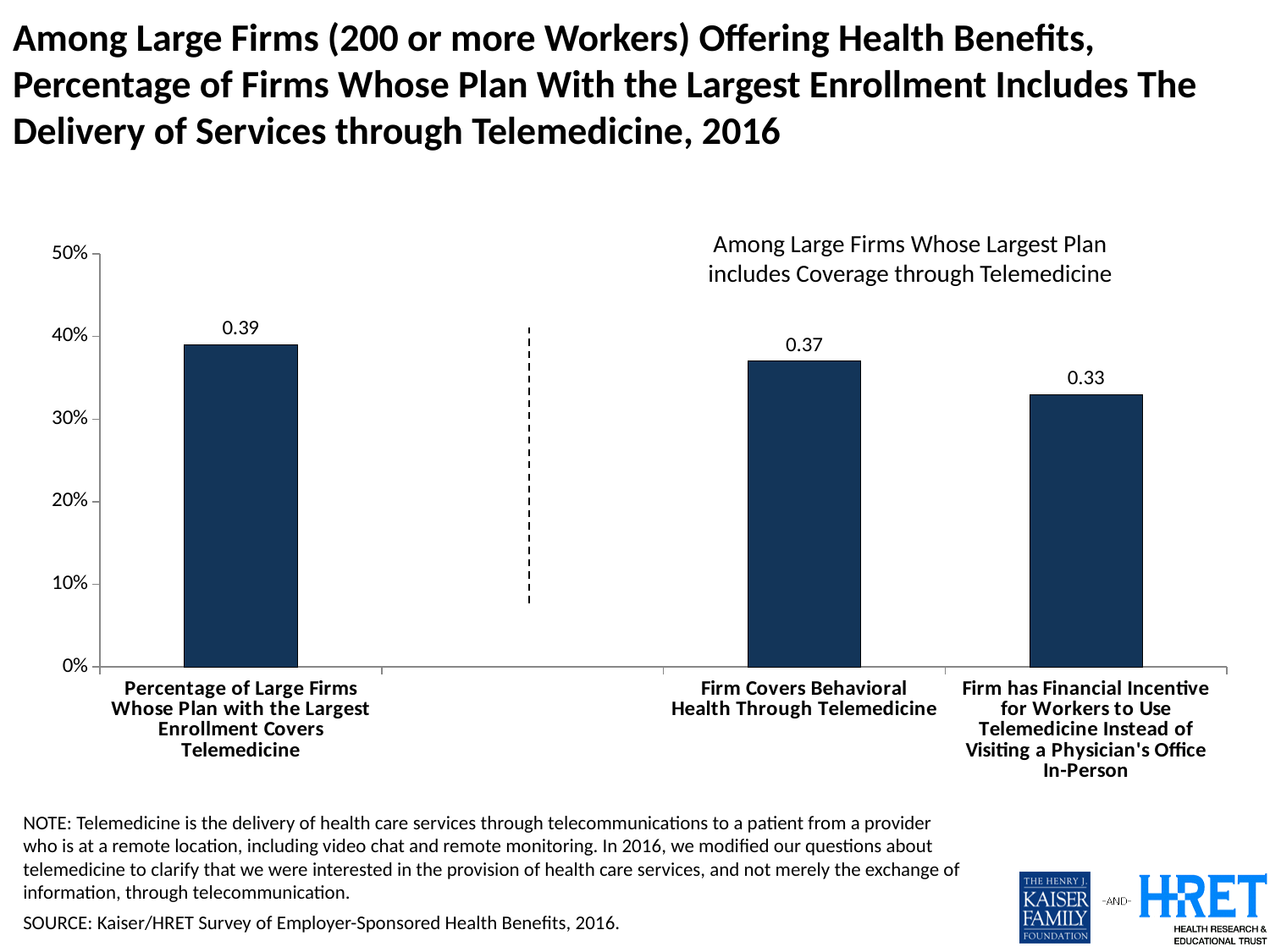
Which is larger: the value for 'Firm Covers Behavioral Health Through Telemedicine' or the value for 'Firm has Financial Incentive for Workers to Use Telemedicine Instead of Visiting a Physician's Office In-Person'? Firm Covers Behavioral Health Through Telemedicine Which category has the lowest value? Firm has Financial Incentive for Workers to Use Telemedicine Instead of Visiting a Physician's Office In-Person Which category has the highest value? Percentage of Large Firms Whose Plan with the Largest Enrollment Covers Telemedicine What is the value for 'Percentage of Large Firms Whose Plan with the Largest Enrollment Covers Telemedicine'? 0.39 What is the highest value shown on the vertical axis? 50% What kind of chart is shown on the slide? bar chart Is the value for 'Firm has Financial Incentive for Workers to Use Telemedicine Instead of Visiting a Physician's Office In-Person' greater or less than 40%? less What is the value for 'Firm has Financial Incentive for Workers to Use Telemedicine Instead of Visiting a Physician's Office In-Person'? 0.33 What is the difference between the value for 'Percentage of Large Firms Whose Plan with the Largest Enrollment Covers Telemedicine' and the value for 'Firm Covers Behavioral Health Through Telemedicine'? 0.02 What is the value for 'Firm Covers Behavioral Health Through Telemedicine'? 0.37 How many bars are plotted on the chart? 3 What is the difference between the value for 'Firm Covers Behavioral Health Through Telemedicine' and the value for 'Firm has Financial Incentive for Workers to Use Telemedicine Instead of Visiting a Physician's Office In-Person'? 0.04